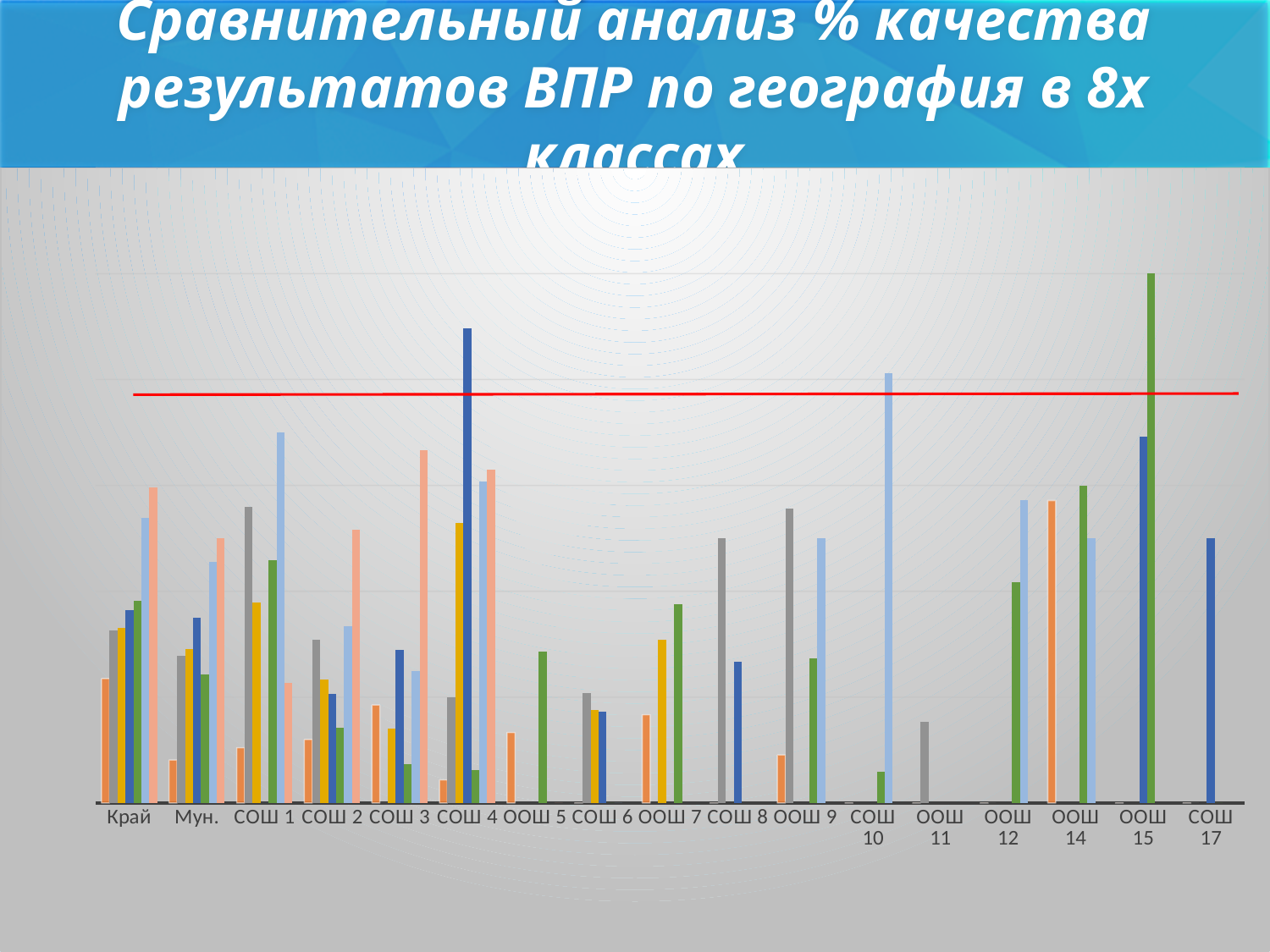
Which category on the x axis contains the tallest bar in the chart? ООШ 15 What is the last category label on the x axis of the chart? СОШ 17 How many categories are shown along the x axis of the chart? 17 What kind of chart is shown on the slide? bar chart What is the first category label on the x axis of the chart? Край